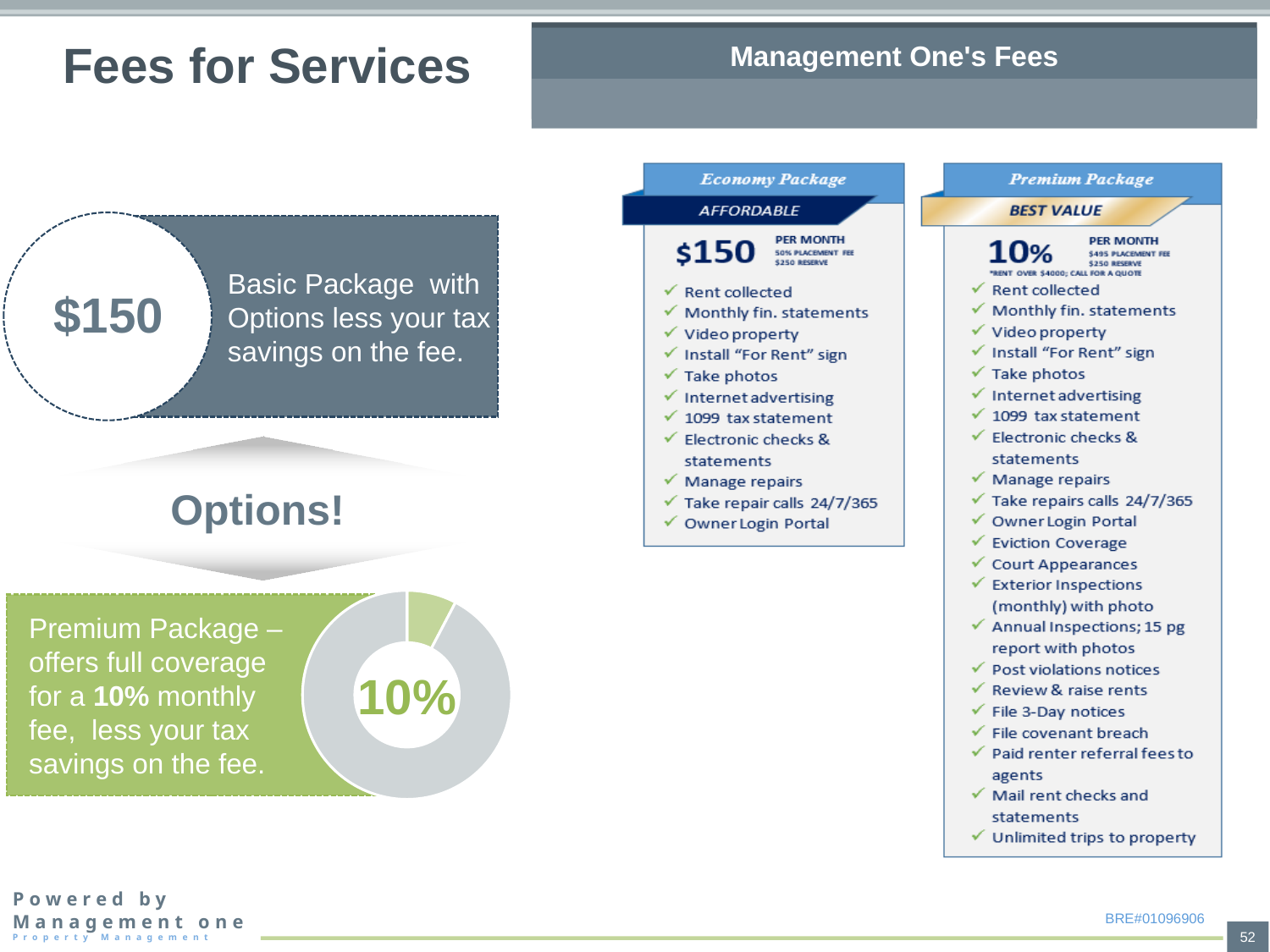
What colour is the smaller slice of the pie chart at the bottom left? green How many slices does the pie chart at the bottom left have? 2 What value is printed in the centre of the pie chart at the bottom left? 10% Does the pie chart at the bottom left have a legend? No In the pie chart at the bottom left, which slice is larger, the green one or the grey one? grey What kind of chart is shown at the bottom left of the slide? doughnut chart